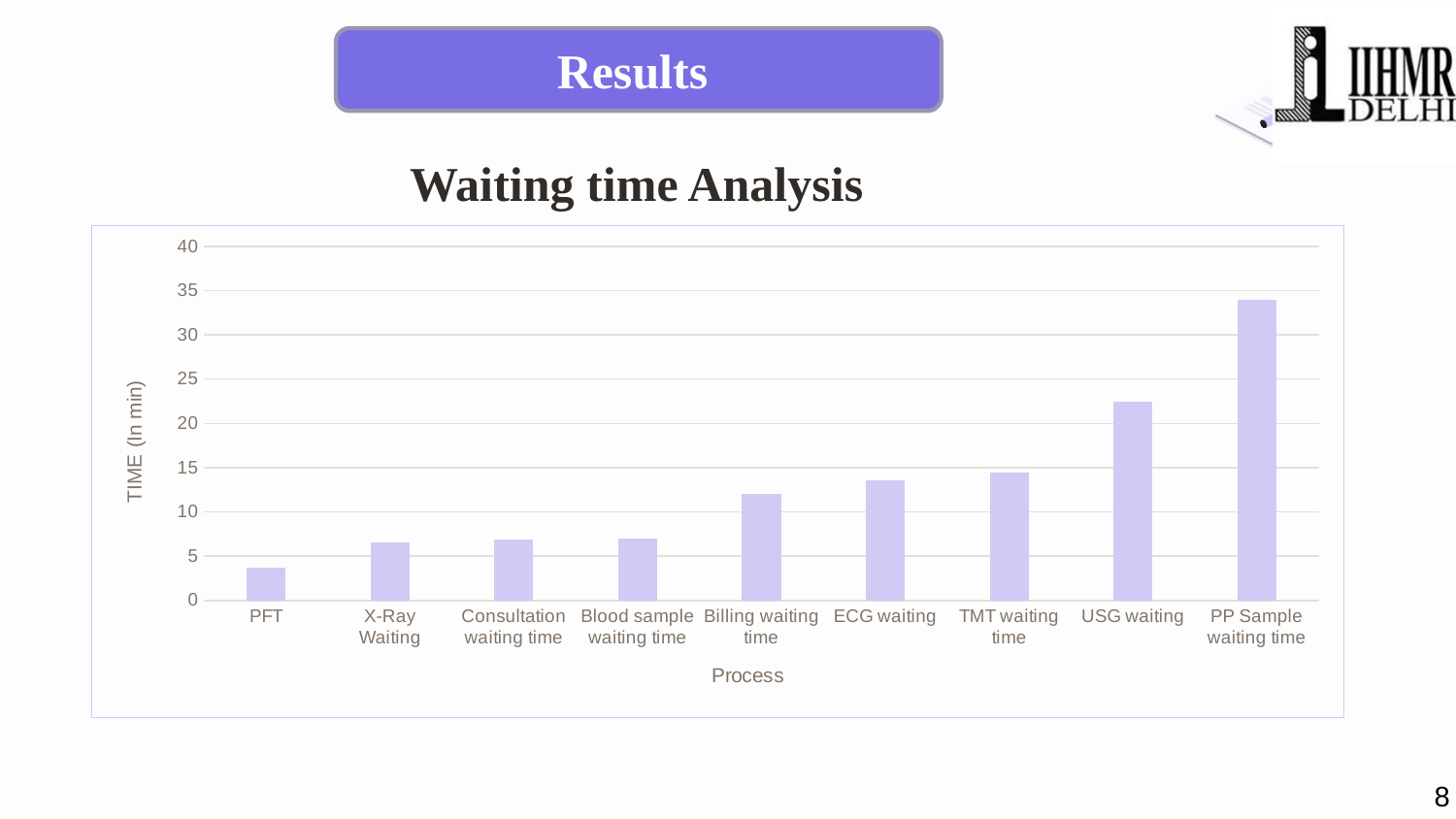
Is the value for PFT greater or less than 5? less Which process has the lowest waiting time? PFT Which process has the highest waiting time? PP Sample waiting time Is the value for USG waiting greater or less than 20? greater Is the value for PP Sample waiting time greater or less than 30? greater Do the waiting times rise or fall moving from left to right along the x axis? rise Which has a larger waiting time, USG waiting or ECG waiting? USG waiting What kind of chart is shown on the slide? bar chart How many processes are plotted on the chart? 9 What is the title of the y axis? TIME (In min)